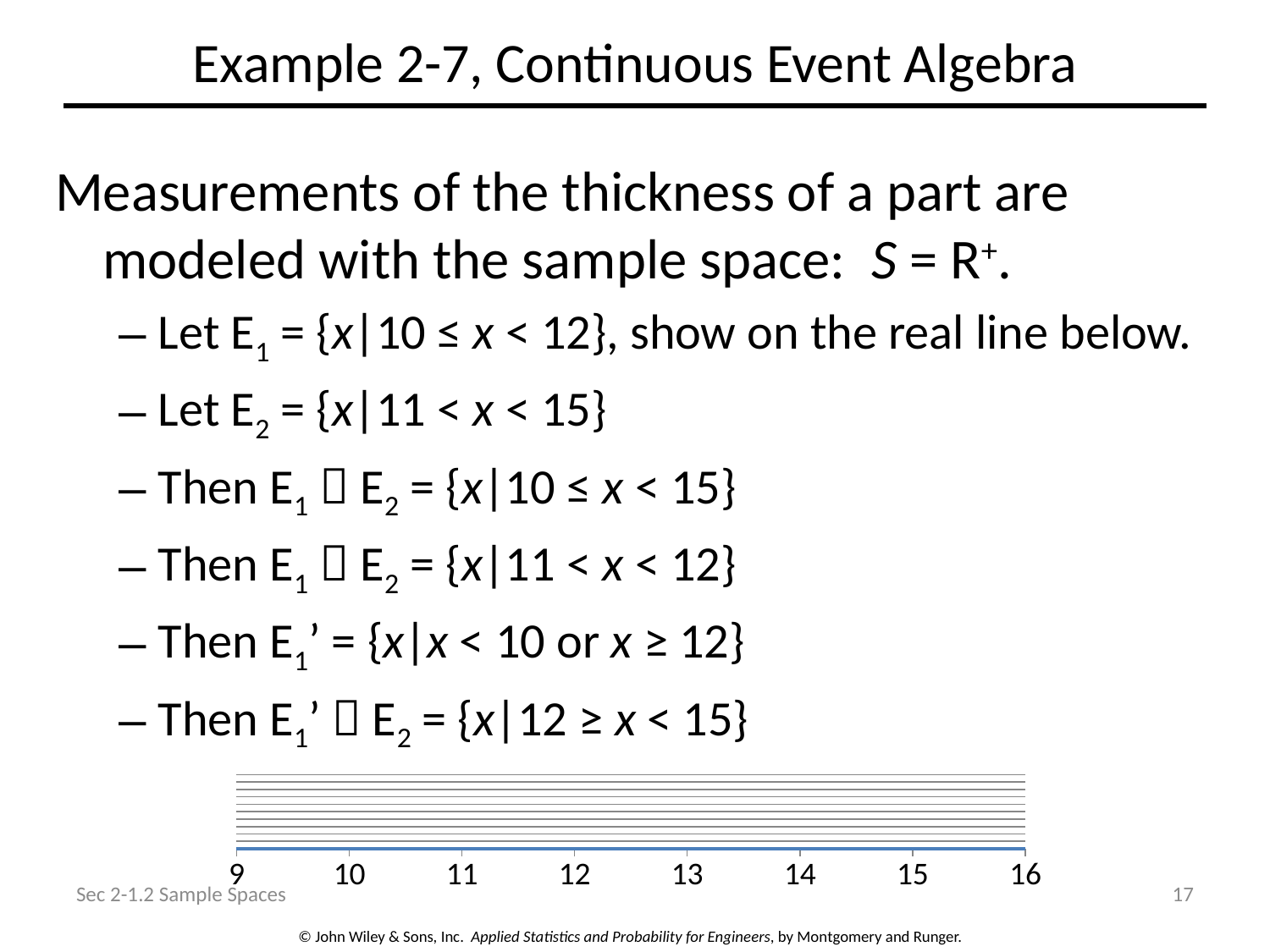
What colour is the plotted line in the chart at the bottom of the slide? blue Does the chart at the bottom of the slide display a legend? No What kind of chart is shown at the bottom of the slide? line chart How many tick labels are shown on the horizontal axis of the chart at the bottom of the slide? 8 What is the largest value labeled on the horizontal axis of the chart at the bottom of the slide? 16 Does the plotted line in the chart at the bottom of the slide rise, fall, or stay flat from left to right? stay flat What is the smallest value labeled on the horizontal axis of the chart at the bottom of the slide? 9